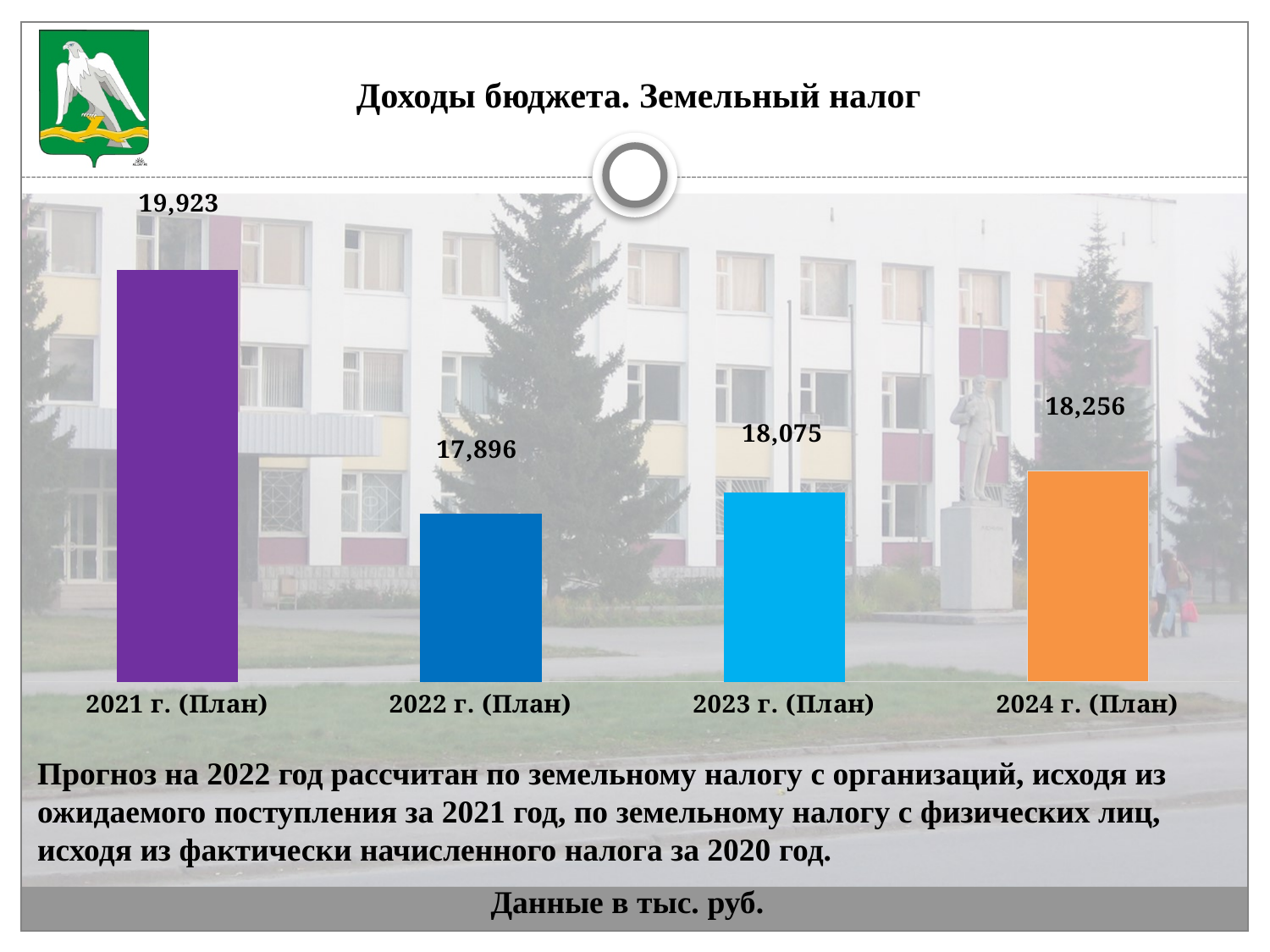
What is the value for 2021 г. (План)? 19,923 What is the difference between the values for 2021 г. (План) and 2022 г. (План)? 2,027 What is the title of the slide? Доходы бюджета. Земельный налог What is the value for 2022 г. (План)? 17,896 What is the difference between the values for 2024 г. (План) and 2023 г. (План)? 181 What is the value for 2023 г. (План)? 18,075 Which is larger, the value for 2023 г. (План) or 2024 г. (План)? 2024 г. (План) Which category has the lowest value? 2022 г. (План) What is the value for 2024 г. (План)? 18,256 How many categories are shown in the chart? 4 Which category has the highest value? 2021 г. (План) What kind of chart is shown on the slide? Bar chart